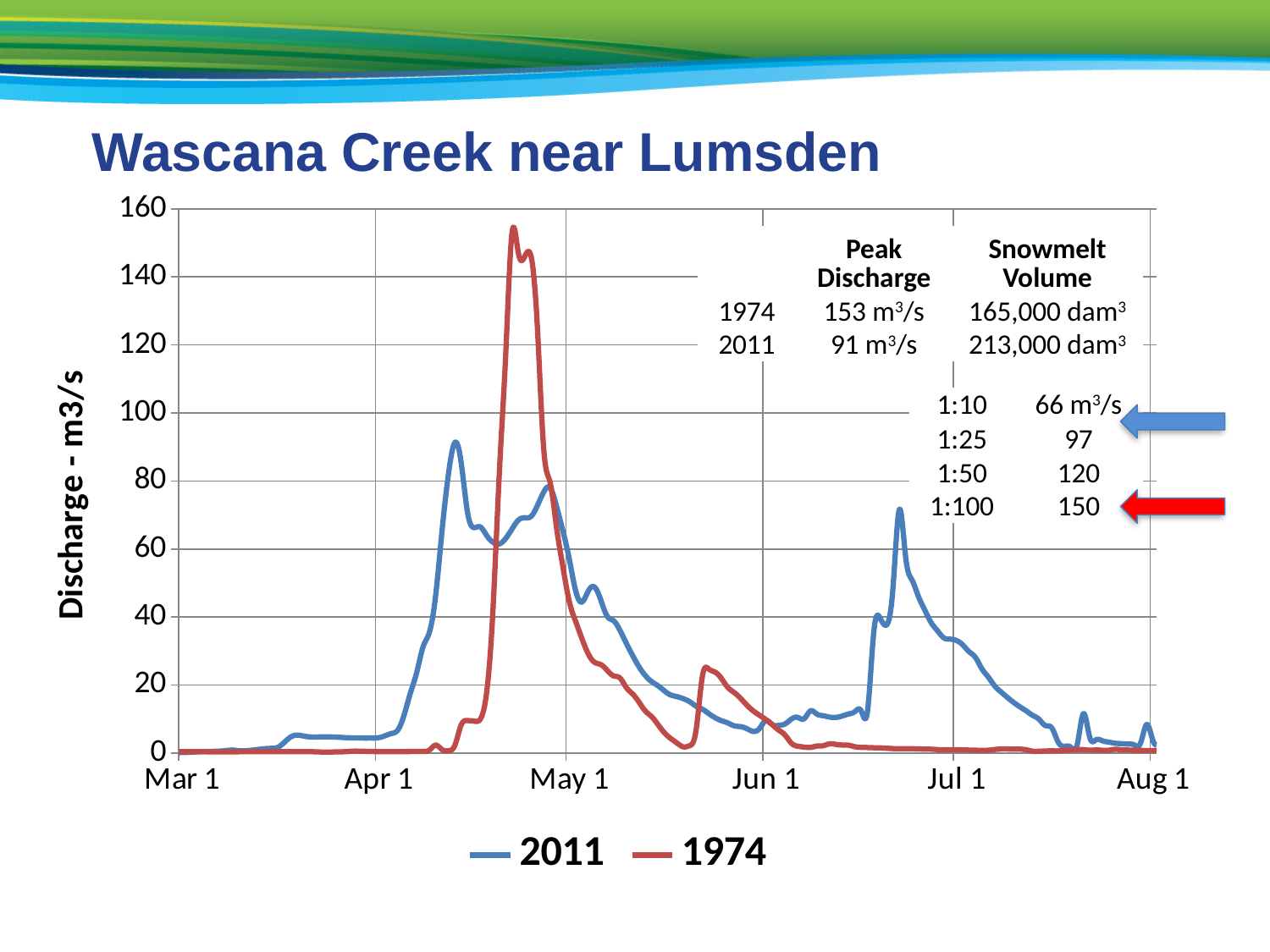
What is the difference between the 2011 and 1974 snowmelt volumes? 48,000 dam³ Is the 2011 discharge around Jun 1 greater or less than 20 m3/s? less What was the peak discharge for 1974 according to the slide? 153 m³/s Which year had the larger snowmelt volume, 1974 or 2011? 2011 What was the peak discharge for 2011 according to the slide? 91 m³/s What is the label of the vertical axis? Discharge - m3/s Which two years are plotted in the chart? 2011 and 1974 Which year had the higher peak discharge, 1974 or 2011? 1974 Is the peak of the 1974 line greater or less than 140 m3/s? greater How many series does the legend list? 2 What kind of chart is shown on the slide? line chart What is the difference between the 1974 and 2011 peak discharges? 62 m³/s